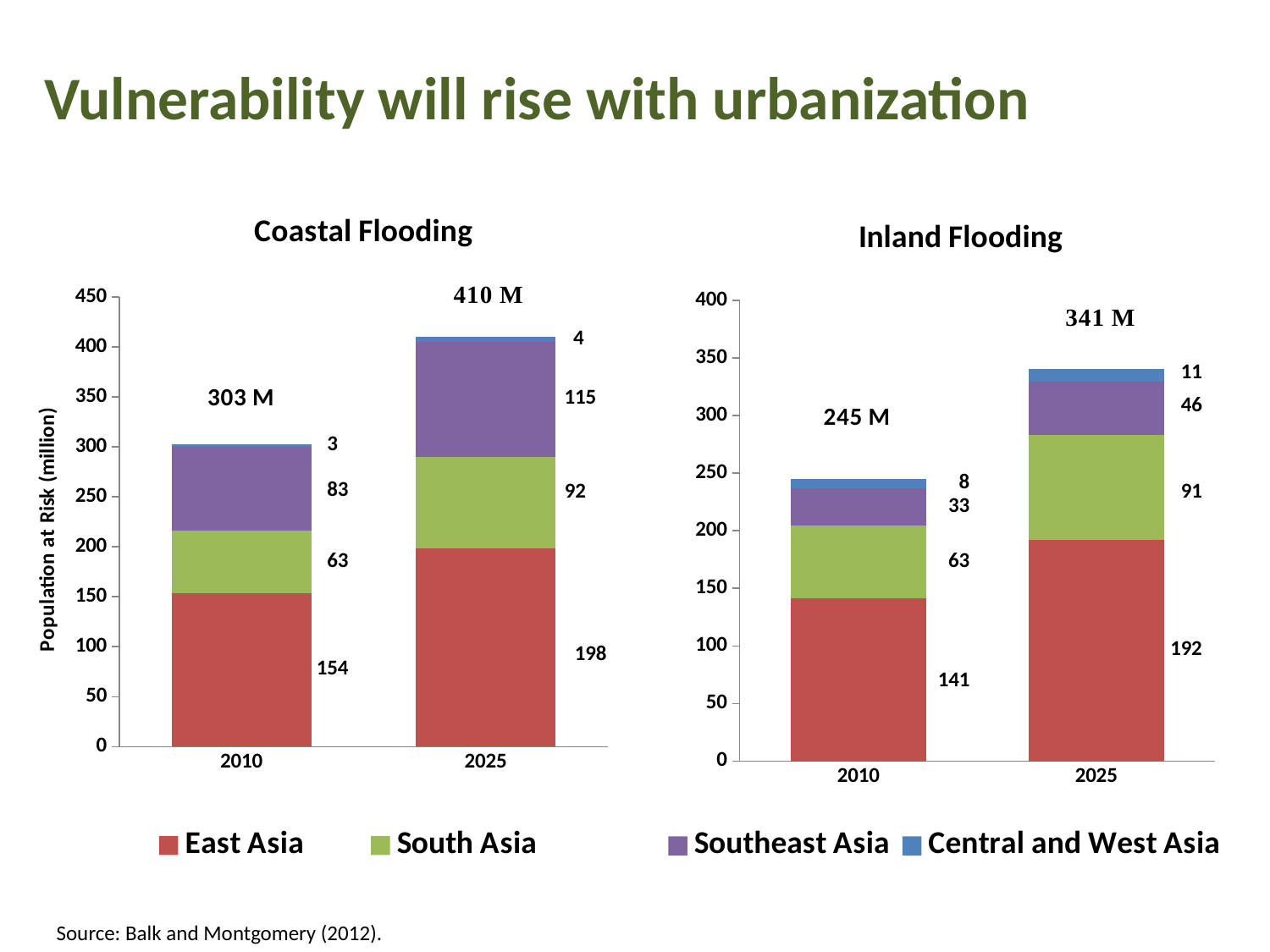
In the Coastal Flooding chart, what is the total population at risk shown for the 2010 bar? 303 M In the Inland Flooding chart, which region has the smallest value in 2025? Central and West Asia In the Coastal Flooding chart, what is the value for East Asia in 2025? 198 In the Coastal Flooding chart, what is the difference between the Southeast Asia values for 2025 and 2010? 32 In the Inland Flooding chart, what is the total population at risk shown for the 2025 bar? 341 M In the Coastal Flooding chart, does the total population at risk rise or fall from 2010 to 2025? rise In the Inland Flooding chart, what is the value for South Asia in 2010? 63 What kind of chart is the Inland Flooding chart? stacked bar chart What is the y-axis label of the Coastal Flooding chart? Population at Risk (million) In the Coastal Flooding chart, which region has the largest value in 2010? East Asia How many series does the legend list? 4 In the Inland Flooding chart, is the East Asia value for 2010 larger or smaller than the East Asia value for 2025? smaller